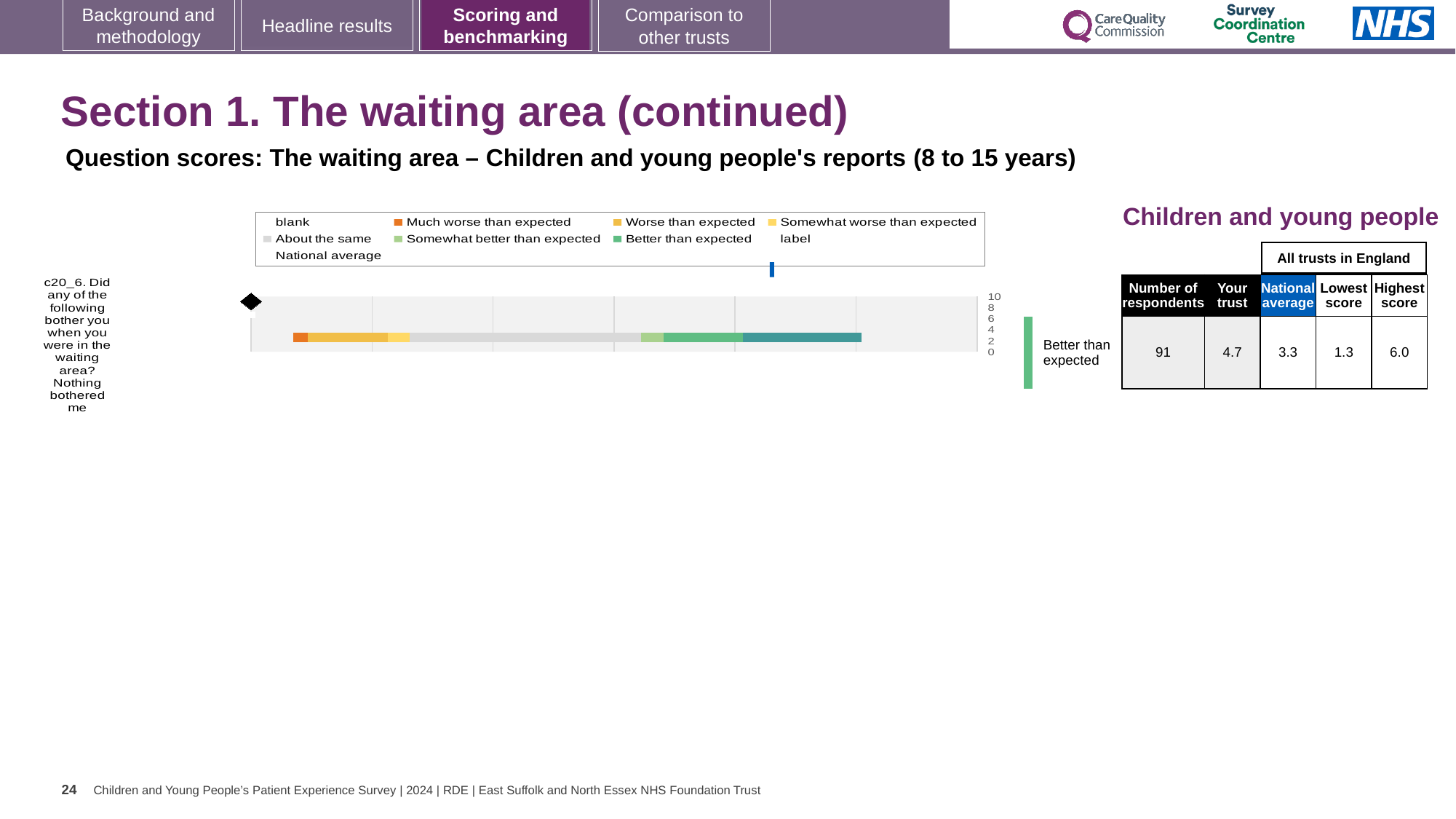
In the table, what is the 'Your trust' score for question c20_6? 4.7 What benchmark category is shown to the right of the bar for question c20_6? Better than expected What colour does the legend use for 'Much worse than expected'? orange In the table, what is the highest score among all trusts in England for question c20_6? 6.0 What is the difference between the 'Your trust' score and the national average for question c20_6? 1.4 What kind of chart is shown on the slide? bar chart Which question is plotted in the chart? c20_6. Did any of the following bother you when you were in the waiting area? Nothing bothered me How many survey questions are plotted in the chart? 1 In the table, what is the lowest score among all trusts in England for question c20_6? 1.3 In the table, how many respondents answered question c20_6? 91 Is the 'Your trust' score for question c20_6 larger or smaller than the national average? larger In the table, what is the national average score for question c20_6? 3.3